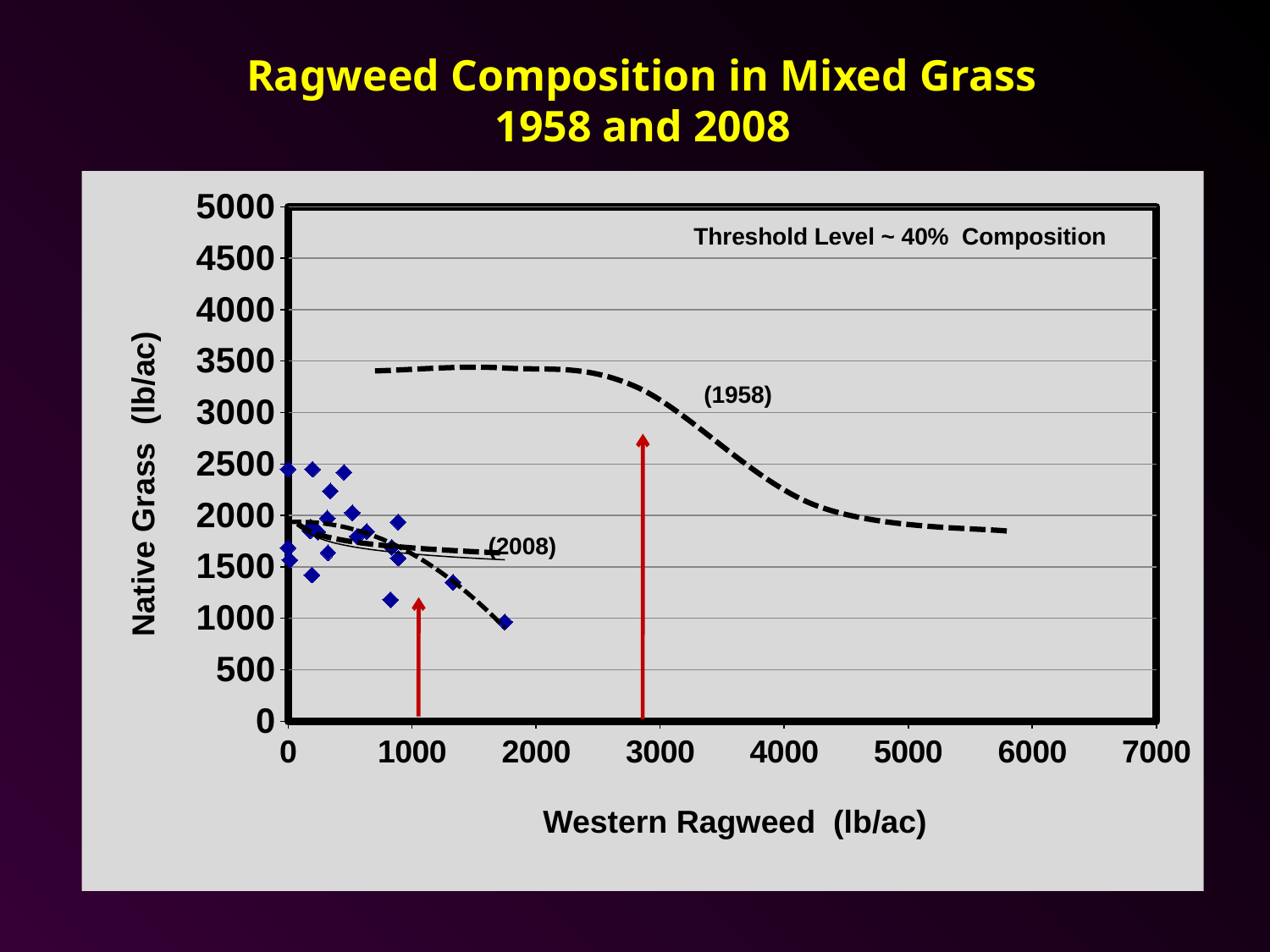
Does the 1958 curve rise or fall as Western Ragweed increases from 3000 to 5000 lb/ac? Fall Is the Native Grass value of the 1958 curve at 1000 lb/ac of Western Ragweed greater or less than 3000? greater Does the 2008 curve rise or fall as Western Ragweed increases along the x axis? Fall Is the Native Grass value of the 2008 curve at 1000 lb/ac of Western Ragweed greater or less than 2000? less What is the label of the x axis? Western Ragweed (lb/ac) What is the maximum value shown on the x axis? 7000 What is the maximum value shown on the y axis? 5000 Is the Native Grass value of the 1958 curve at 5000 lb/ac of Western Ragweed greater or less than 2500? less What kind of chart is shown on the slide? Scatter chart with trend lines Which curve shows higher Native Grass values, the 1958 curve or the 2008 curve? 1958